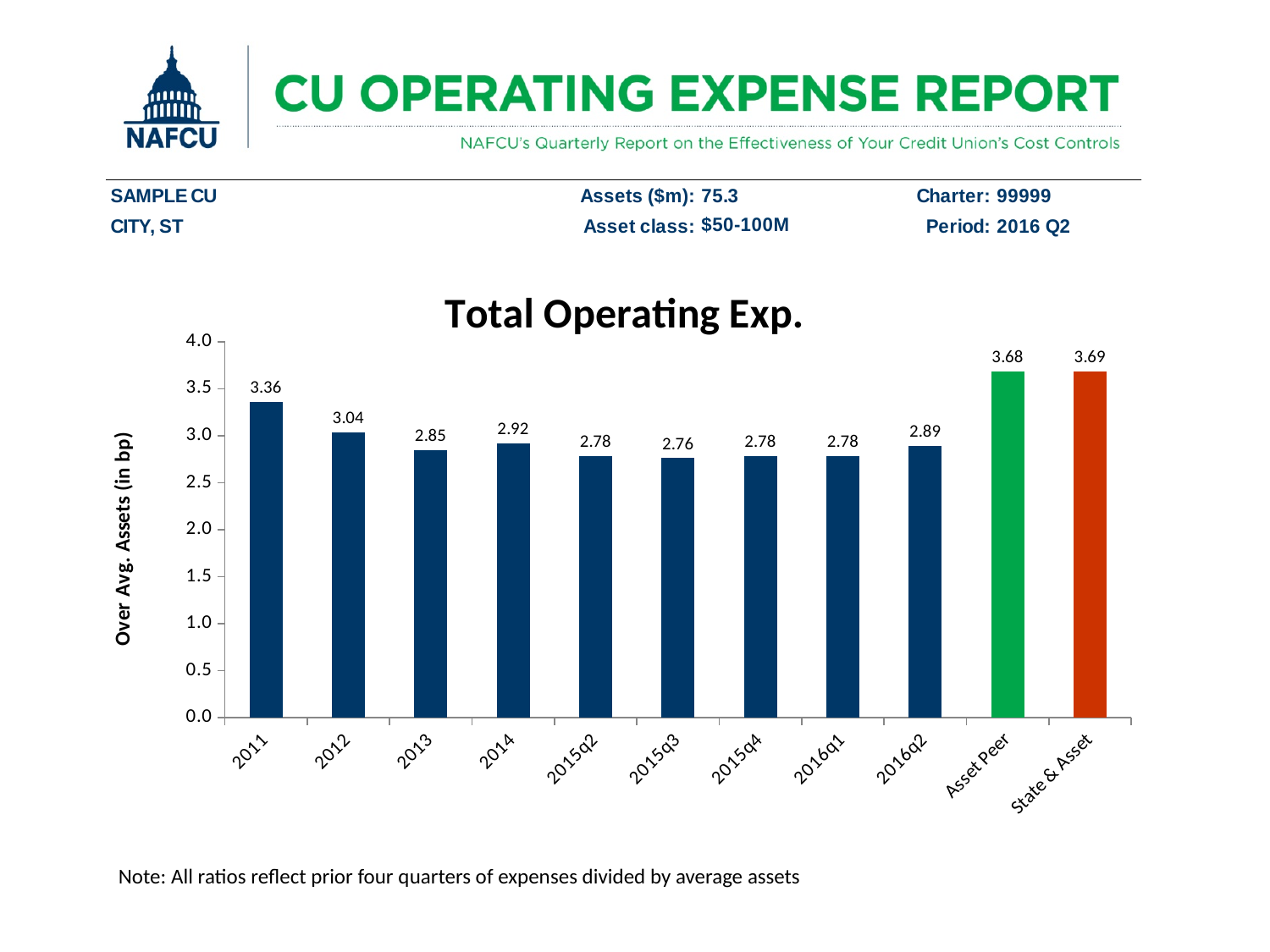
What is the value for 2011 in the Total Operating Exp. chart? 3.36 Which category has the lowest value in the Total Operating Exp. chart? 2015q3 Is the value for 2015q2 greater or less than 3.0 in the Total Operating Exp. chart? less What is the y-axis label of the Total Operating Exp. chart? Over Avg. Assets (in bp) What is the difference between the values for 2011 and 2012 in the Total Operating Exp. chart? 0.32 Which is larger in the Total Operating Exp. chart, the value for 2013 or the value for 2014? 2014 Which category has the highest value in the Total Operating Exp. chart? State & Asset What is the value for Asset Peer in the Total Operating Exp. chart? 3.68 What is the difference between the State & Asset value and the 2016q2 value in the Total Operating Exp. chart? 0.80 How many bars are shown in the Total Operating Exp. chart? 11 What kind of chart is the Total Operating Exp. chart? bar chart What is the value for 2016q2 in the Total Operating Exp. chart? 2.89